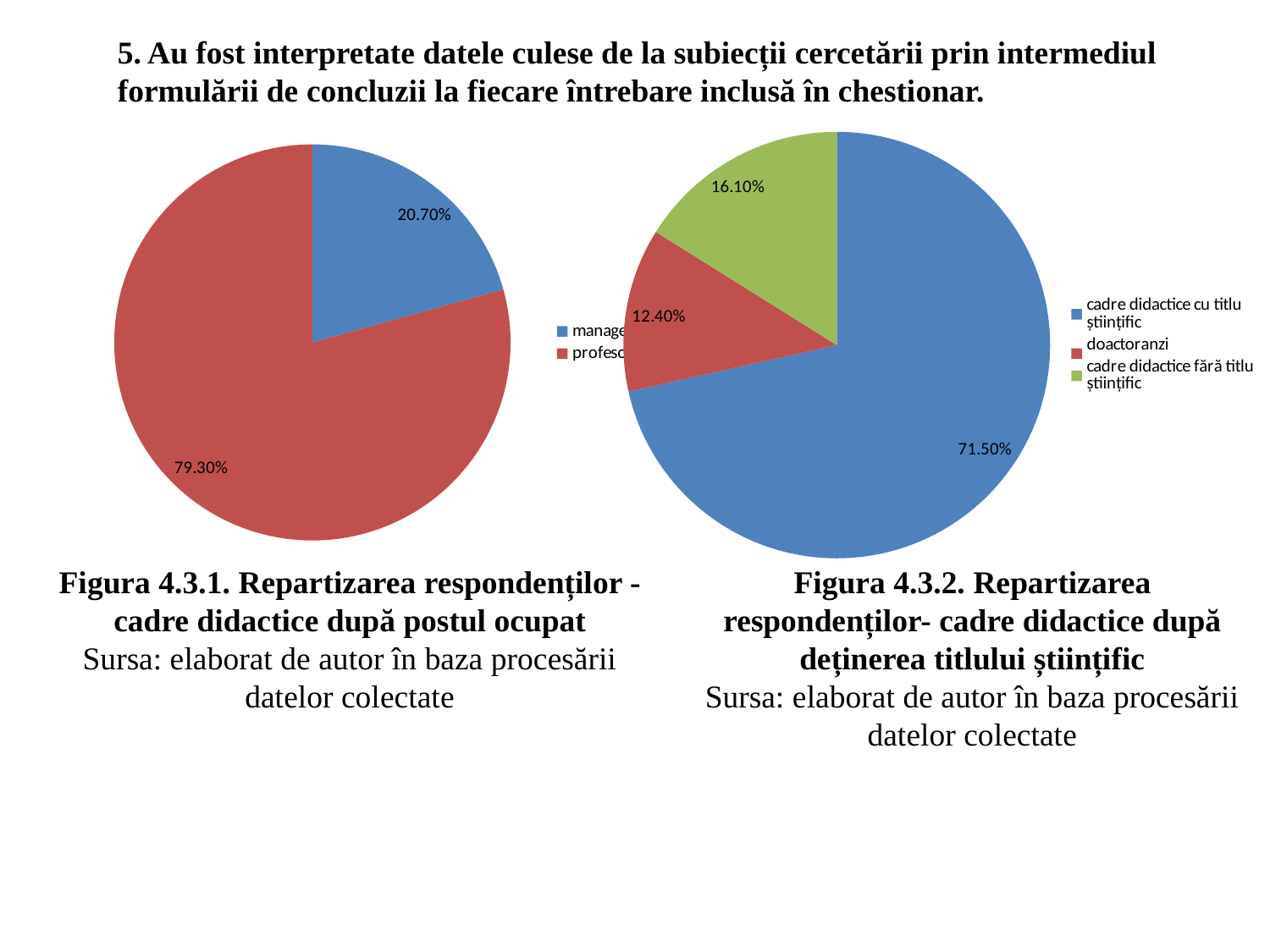
In Figura 4.3.2, how many categories does the legend list? 3 In Figura 4.3.2, what is the difference between cadre didactice cu titlu științific and doactoranzi? 59.10% In Figura 4.3.2, which category has the largest share? cadre didactice cu titlu științific In Figura 4.3.1, what is the value of the smallest slice? 20.70% In Figura 4.3.1, what is the value of the largest slice? 79.30% In Figura 4.3.1, how many slices does the pie have? 2 In Figura 4.3.2, what is the share for cadre didactice fără titlu științific? 16.10% What kind of chart is Figura 4.3.1? pie chart In Figura 4.3.1, what is the difference between the two slices? 58.60% In Figura 4.3.2, what is the share for cadre didactice cu titlu științific? 71.50% In Figura 4.3.2, what is the share for doactoranzi? 12.40% In Figura 4.3.2, which category has the smallest share? doactoranzi